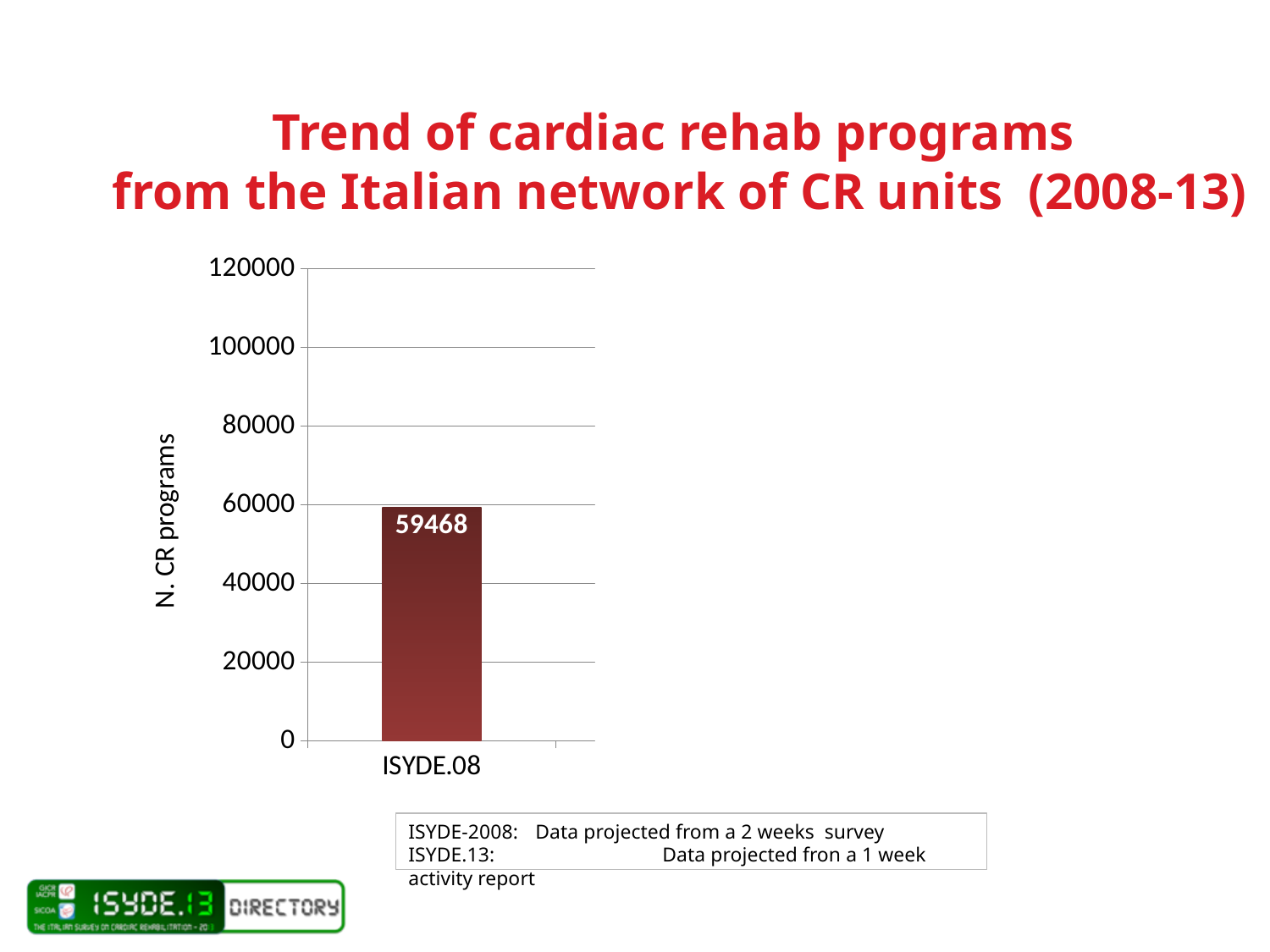
Is the value for ISYDE.08 greater or less than 80000? less What is the label on the vertical axis of the chart? N. CR programs What is the value for ISYDE.08? 59468 What kind of chart is shown on the slide? bar chart How many bars are plotted in the chart? 1 What is the highest value shown on the vertical axis? 120000 What is the category label of the bar shown in the chart? ISYDE.08 Is the value for ISYDE.08 greater or less than 40000? greater